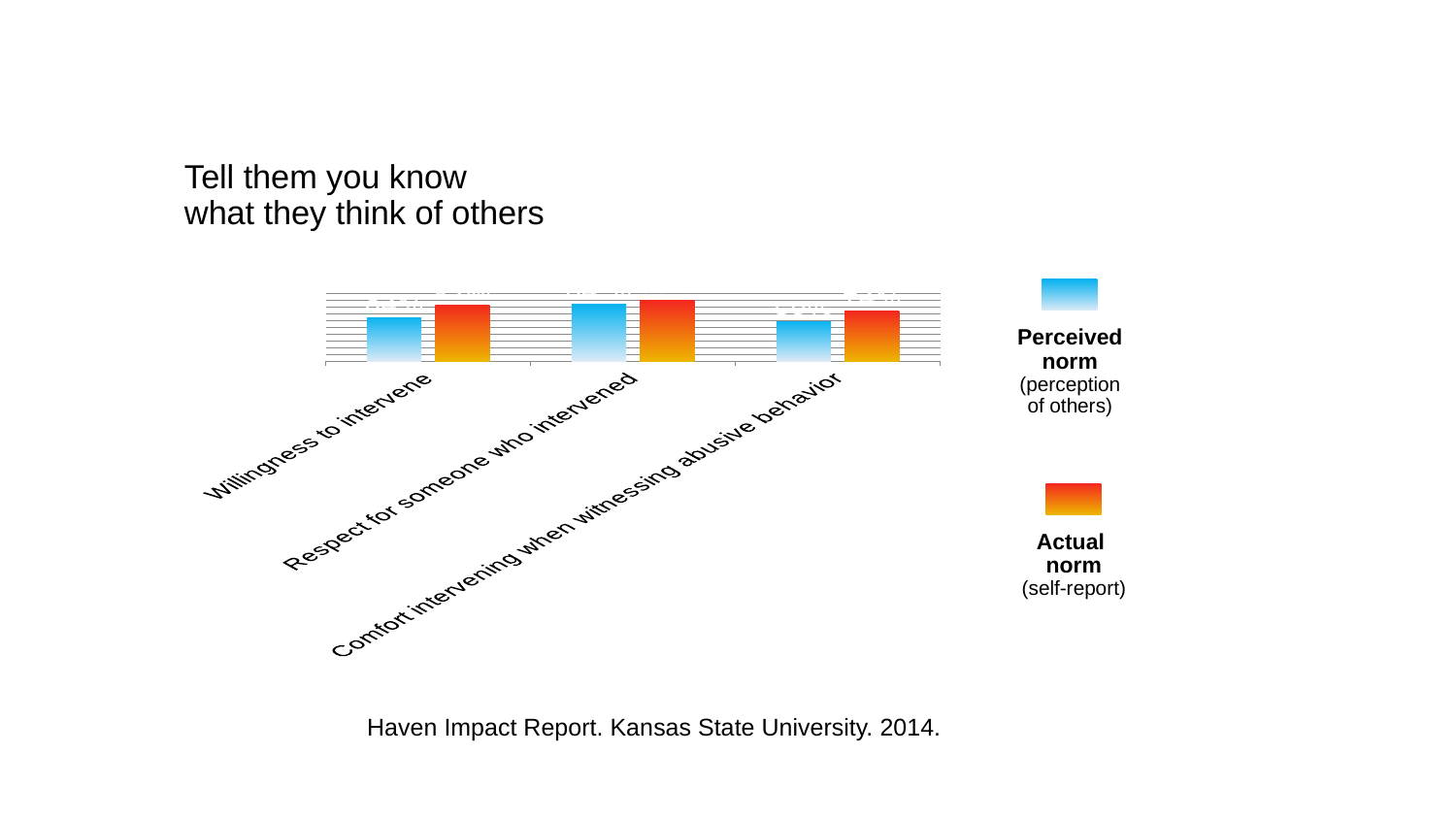
For 'Comfort intervening when witnessing abusive behavior', which is larger: the Perceived norm or the Actual norm? Actual norm Which category has the highest Actual norm value? Respect for someone who intervened How many series does the chart's legend list? 2 How many categories are shown on the x axis of the chart? 3 Which category has the highest Perceived norm value? Respect for someone who intervened Which colour represents the Perceived norm series in the chart? blue For 'Willingness to intervene', which is larger: the Perceived norm or the Actual norm? Actual norm For 'Respect for someone who intervened', which is larger: the Perceived norm or the Actual norm? Actual norm What is the source cited below the chart? Haven Impact Report. Kansas State University. 2014. What kind of chart is shown on the slide? bar chart